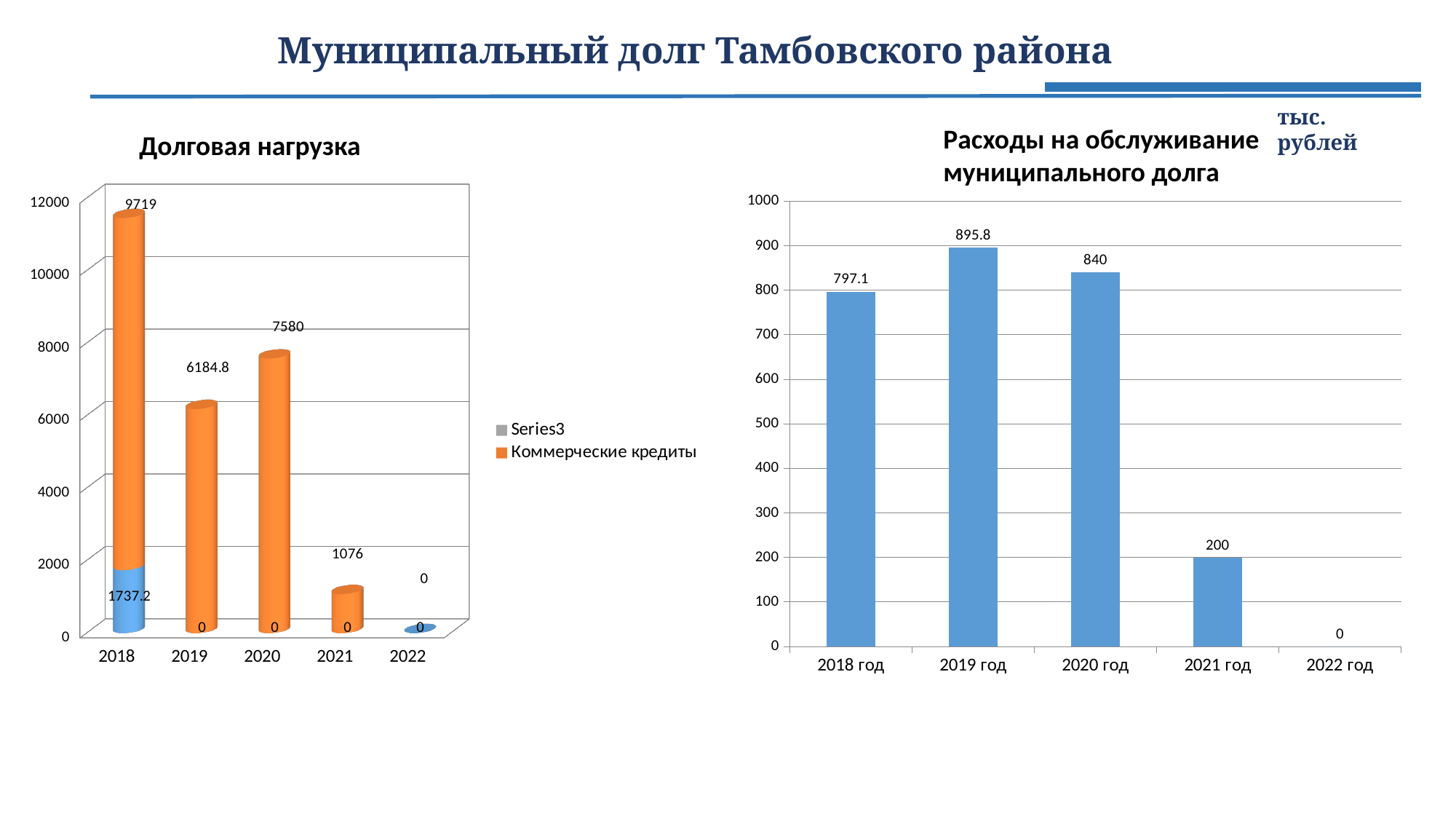
In the chart 'Долговая нагрузка', what is the difference between the Коммерческие кредиты values for 2020 and 2019? 1395.2 In the chart 'Расходы на обслуживание муниципального долга', which year has the highest value? 2019 год In the chart 'Долговая нагрузка', which year has the highest value of Коммерческие кредиты? 2018 How many years are shown on the x axis of the chart 'Расходы на обслуживание муниципального долга'? 5 In the chart 'Долговая нагрузка', what is the value of Коммерческие кредиты for 2020? 7580 How many series does the legend of the chart 'Долговая нагрузка' list? 2 In the chart 'Расходы на обслуживание муниципального долга', which is larger: the value for 2018 год or 2020 год? 2020 год In the chart 'Расходы на обслуживание муниципального долга', what is the difference between the values for 2019 год and 2020 год? 55.8 In the chart 'Расходы на обслуживание муниципального долга', what is the value for 2019 год? 895.8 What kind of chart is 'Расходы на обслуживание муниципального долга'? bar chart In the chart 'Расходы на обслуживание муниципального долга', do the values rise or fall from 2019 год to 2022 год? fall In the chart 'Расходы на обслуживание муниципального долга', which year has the lowest value? 2022 год